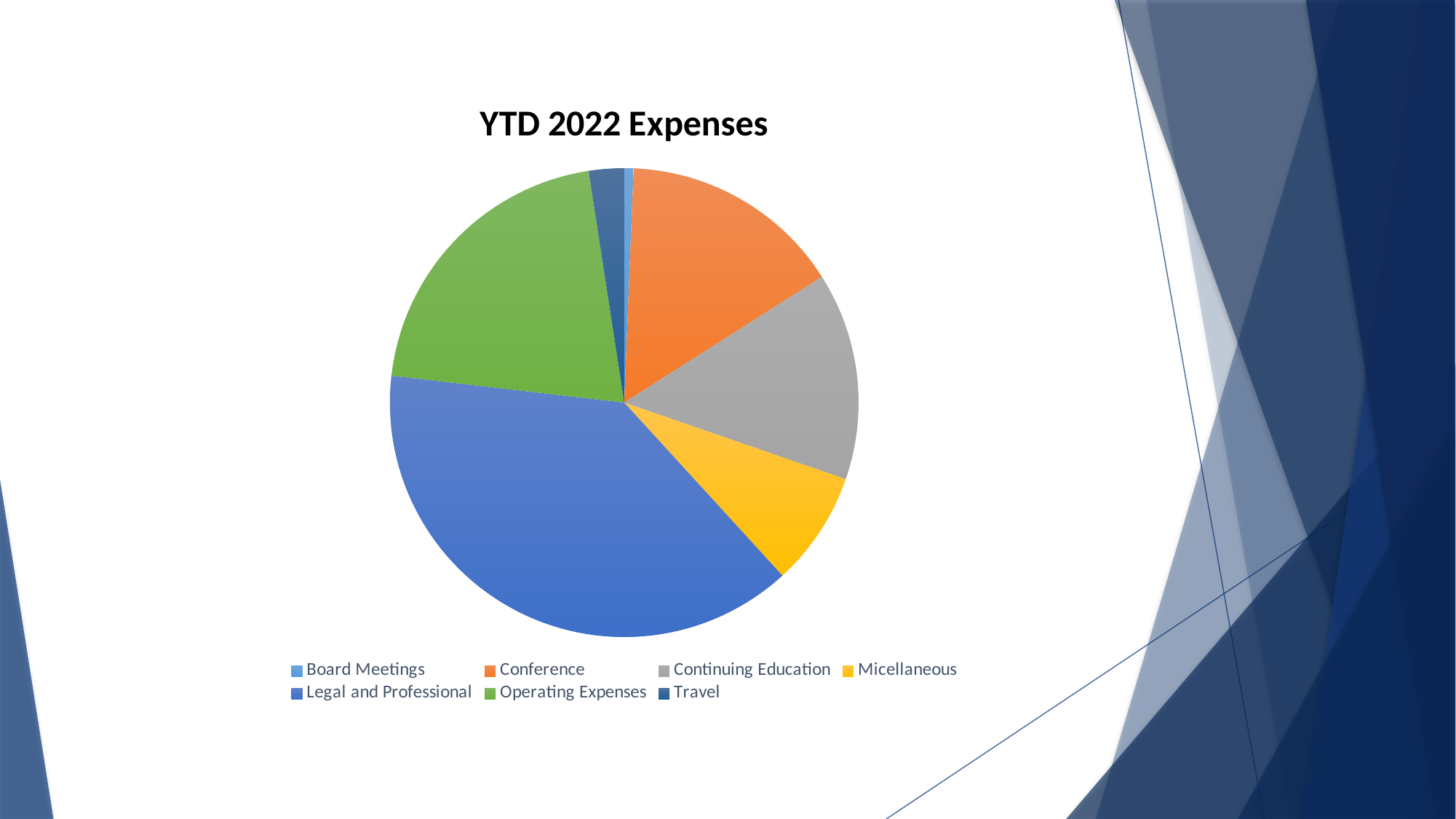
Which is larger, Conference or Micellaneous? Conference How many categories does the pie chart have? 7 Which is larger, Travel or Board Meetings? Travel What colour is the Operating Expenses slice? Green Which is larger, Legal and Professional or Operating Expenses? Legal and Professional Which category has the smallest slice of the pie? Board Meetings What kind of chart is shown on the slide? Pie chart Which category has the largest slice of the pie? Legal and Professional What is the title of the chart? YTD 2022 Expenses